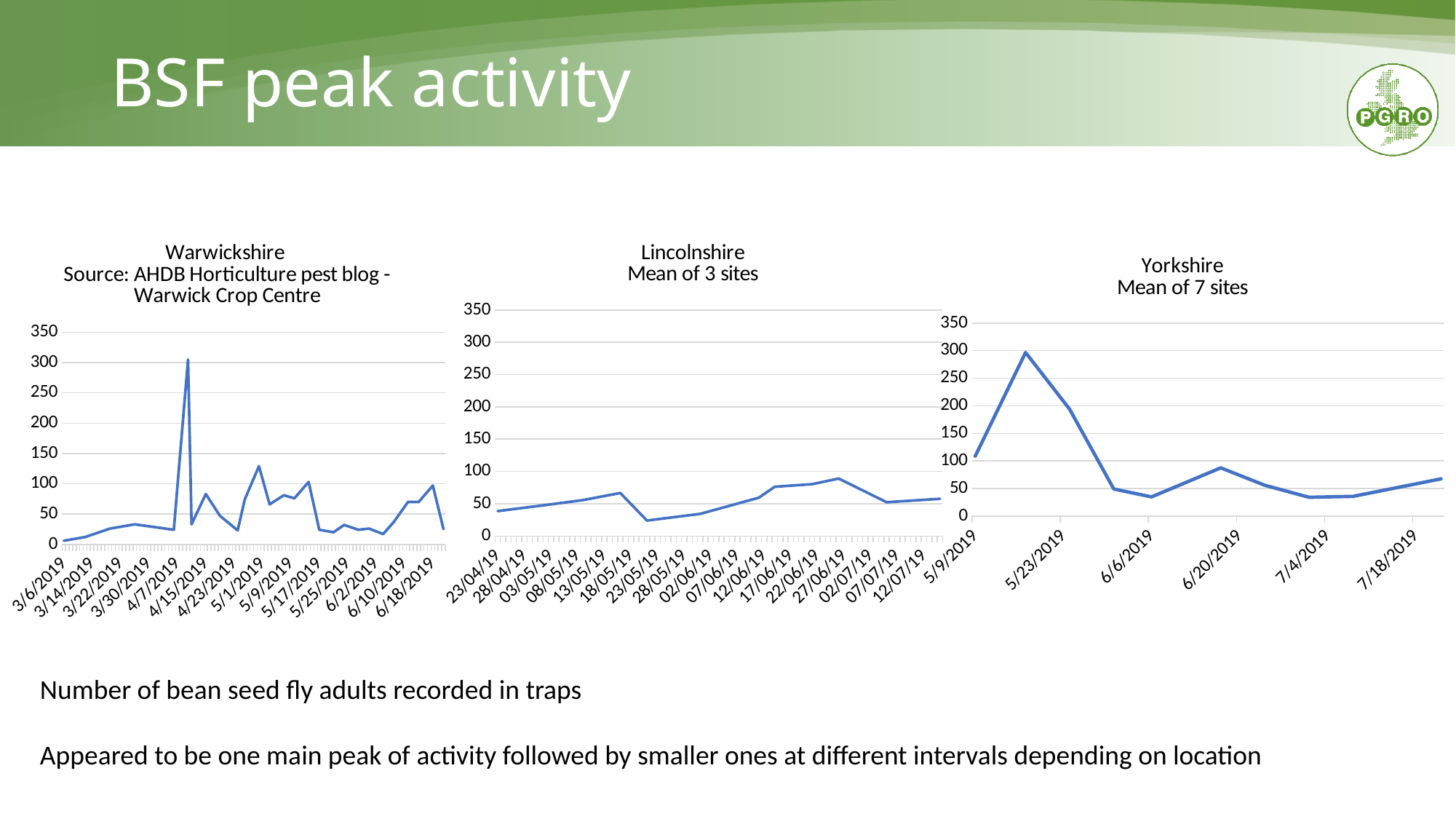
According to its title, the Lincolnshire chart shows the mean of how many sites? 3 sites In the Lincolnshire chart, is the value for 23/05/19 greater or less than 50? less In the Lincolnshire chart, do values rise or fall between 23/05/19 and 27/06/19? rise In the Yorkshire chart, is the value for 6/20/2019 greater or less than 50? greater How many date labels are shown on the x axis of the Yorkshire chart? 6 In the Lincolnshire chart, is the value for 27/06/19 greater or less than 100? less What type of chart is the Warwickshire chart? line chart In the Yorkshire chart, do values rise or fall between 5/23/2019 and 6/6/2019? fall